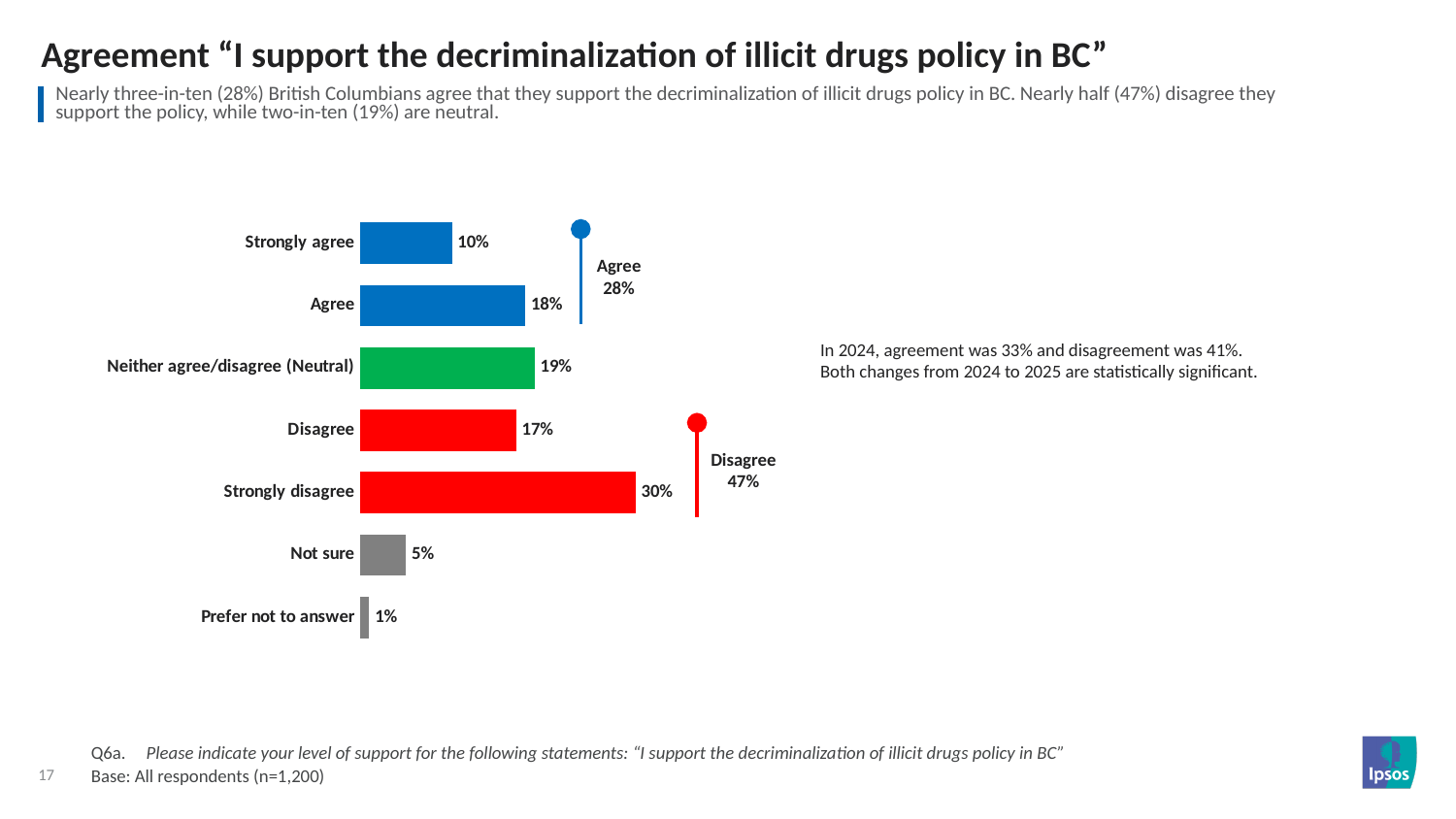
What percentage of respondents strongly agree with the statement? 10% What is the difference in percentage points between 'Strongly disagree' and 'Strongly agree'? 20 percentage points Which response category has the highest percentage? Strongly disagree What percentage of respondents answered 'Not sure'? 5% What percentage of respondents strongly disagree with the statement? 30% What is the combined 'Disagree' total shown on the chart? 47% Which response category has the lowest percentage? Prefer not to answer What type of chart is shown on the slide? Bar chart Which is larger, the percentage for 'Agree' or the percentage for 'Disagree'? Agree What is the combined 'Agree' total shown on the chart? 28% How many response categories are shown in the chart? 7 What colour are the bars for 'Disagree' and 'Strongly disagree'? Red